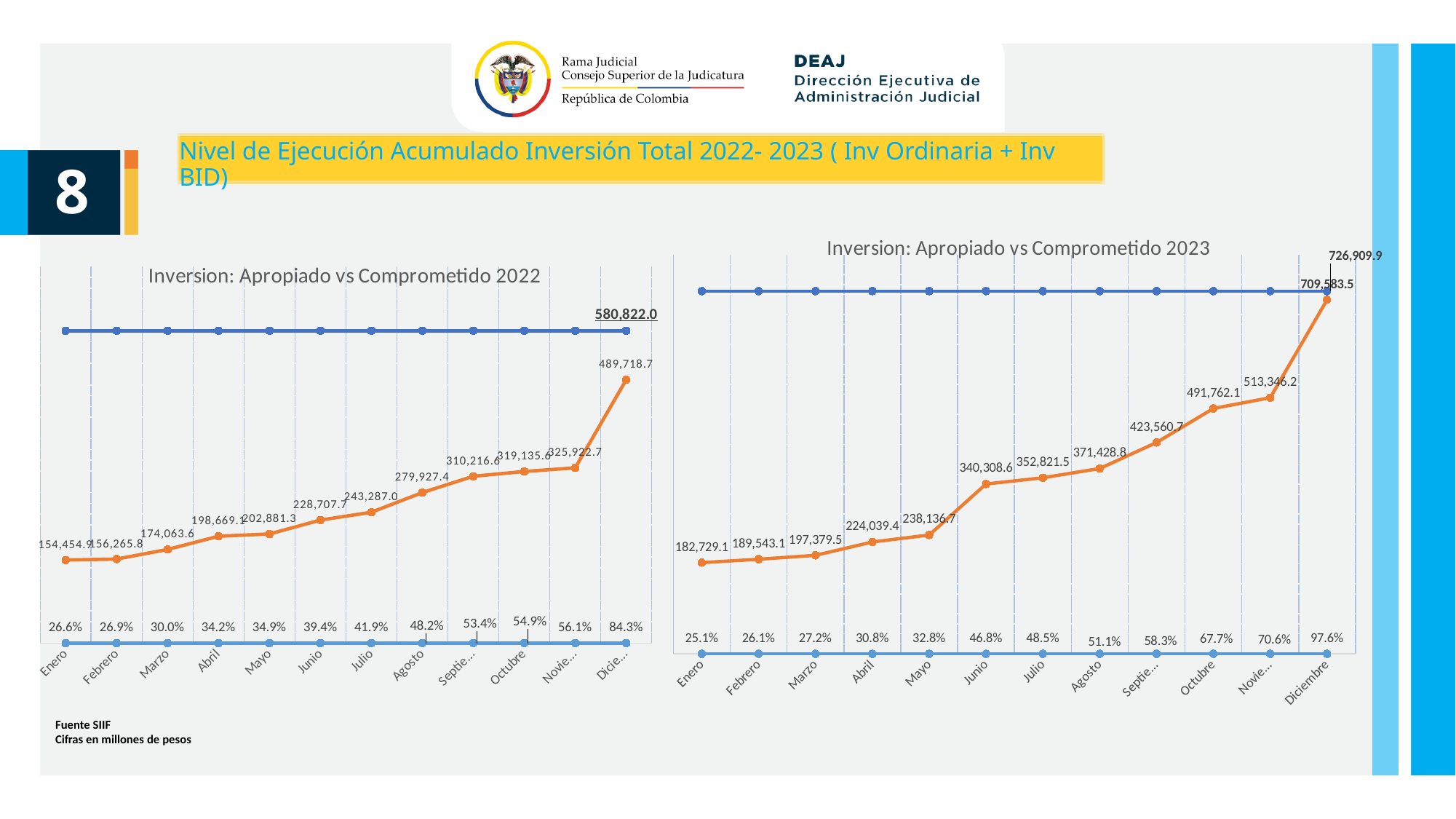
What type of chart is 'Inversion: Apropiado vs Comprometido 2022'? line chart In the chart 'Inversion: Apropiado vs Comprometido 2023', what percentage is shown for Diciembre? 97.6% In the chart 'Inversion: Apropiado vs Comprometido 2022', what percentage is shown for Agosto? 48.2% In the chart 'Inversion: Apropiado vs Comprometido 2022', which month has the highest value on the orange line? Diciembre In the chart 'Inversion: Apropiado vs Comprometido 2023', what is the difference between the orange line values for Diciembre and Noviembre? 196,237.3 In the chart 'Inversion: Apropiado vs Comprometido 2023', which month has the lowest value on the orange line? Enero In the chart 'Inversion: Apropiado vs Comprometido 2023', does the orange line rise or fall from Enero to Diciembre? rise How many months are plotted on the x axis of the chart 'Inversion: Apropiado vs Comprometido 2023'? 12 In the chart 'Inversion: Apropiado vs Comprometido 2022', is the orange line value for Julio larger or smaller than the value for Agosto? smaller In the chart 'Inversion: Apropiado vs Comprometido 2023', what is the value of the orange line for Junio? 340,308.6 In the chart 'Inversion: Apropiado vs Comprometido 2022', what value is labelled on the flat blue line at the top? 580,822.0 In the chart 'Inversion: Apropiado vs Comprometido 2022', what is the value of the orange line for Diciembre? 489,718.7